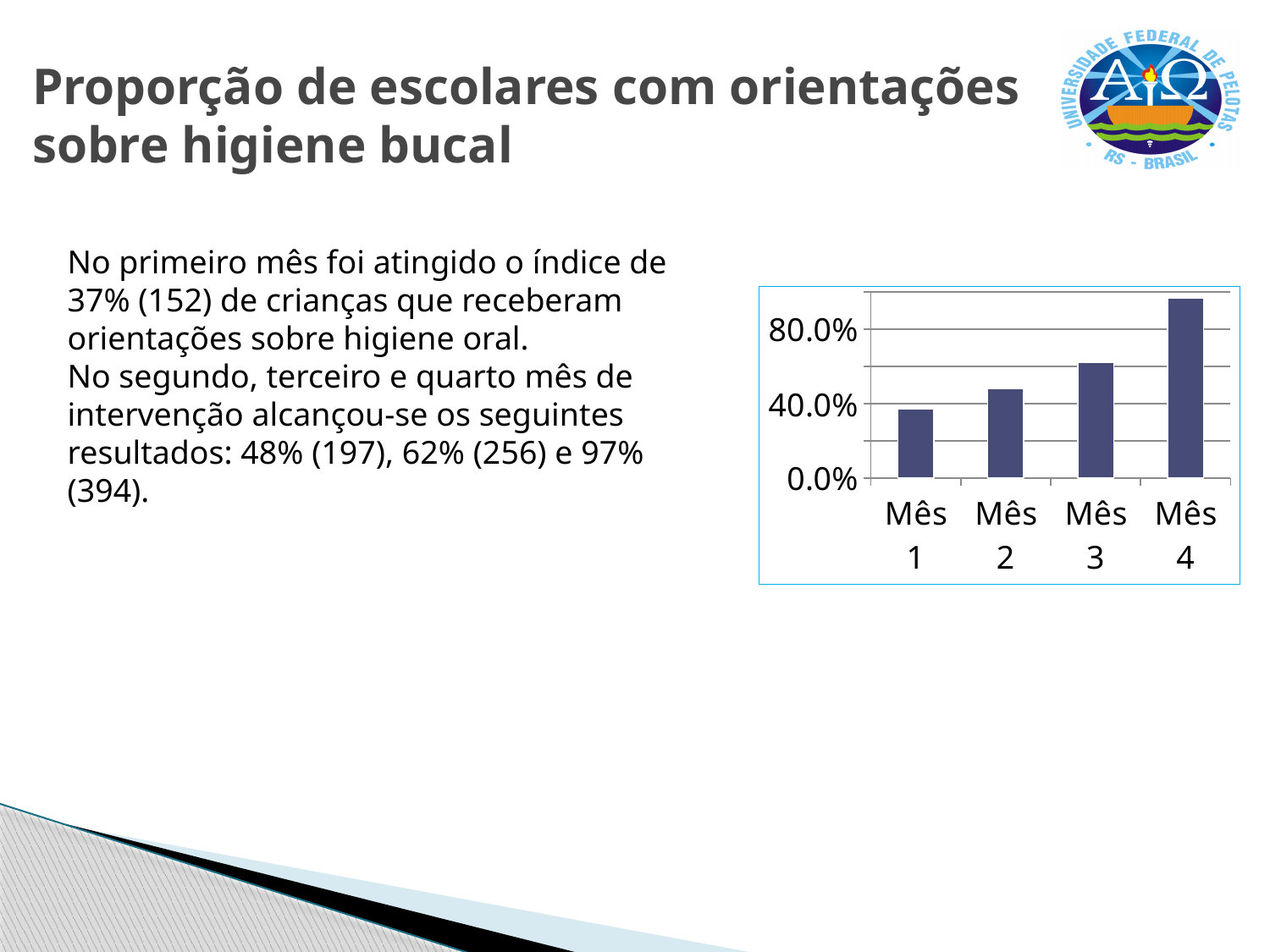
What kind of chart is shown on the slide? bar chart Which month has the highest bar in the chart? Mês 4 Is the value for Mês 1 greater or less than 40.0%? less What colour are the bars in the chart? dark blue Which month has the lowest bar in the chart? Mês 1 Is the value for Mês 4 greater or less than 80.0%? greater How many categories (months) are shown on the x axis of the chart? 4 Is the value for Mês 3 greater or less than 80.0%? less Which is larger, the value for Mês 2 or the value for Mês 3? Mês 3 What is the highest tick label shown on the y axis of the chart? 80.0% Do the values rise or fall from Mês 1 to Mês 4? rise